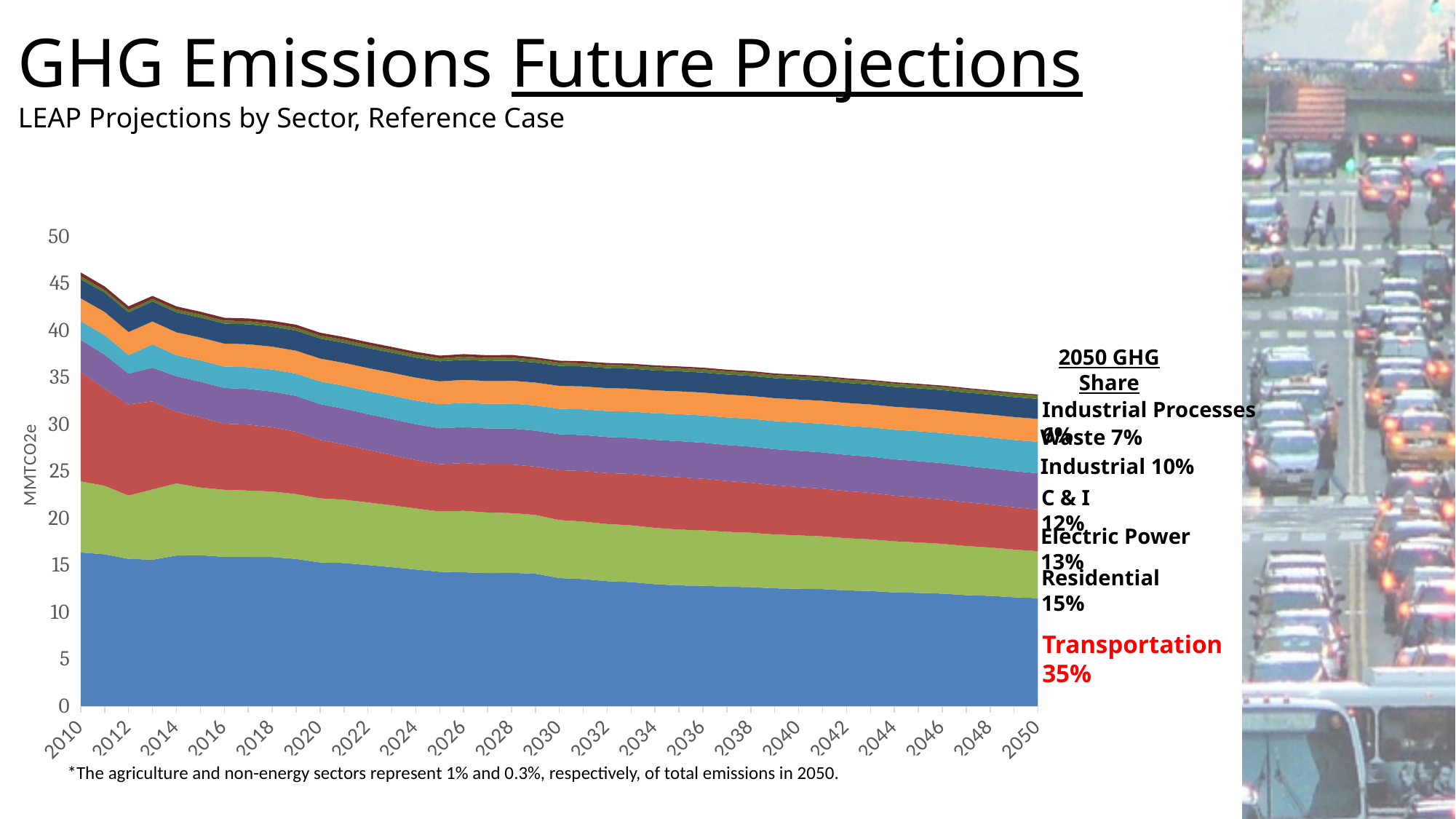
How many percentage points larger is Transportation's 2050 share than Residential's? 20 percentage points What is the Electric Power sector's share of 2050 GHG emissions? 13% What is the Waste sector's share of 2050 GHG emissions? 7% What is Transportation's share of 2050 GHG emissions according to the chart annotation? 35% Which has a larger 2050 GHG share, Residential or Electric Power? Residential Is the Transportation value in 2050 greater or less than 15 MMTCO2e? less Is the total emissions value in 2050 greater or less than 35 MMTCO2e? less Which sector has the largest share of 2050 GHG emissions? Transportation What unit is shown on the y-axis of the chart? MMTCO2e Do total GHG emissions rise or fall from 2010 to 2050 in the chart? Fall What kind of chart is shown on the slide? Stacked area chart What is the Residential sector's share of 2050 GHG emissions? 15%